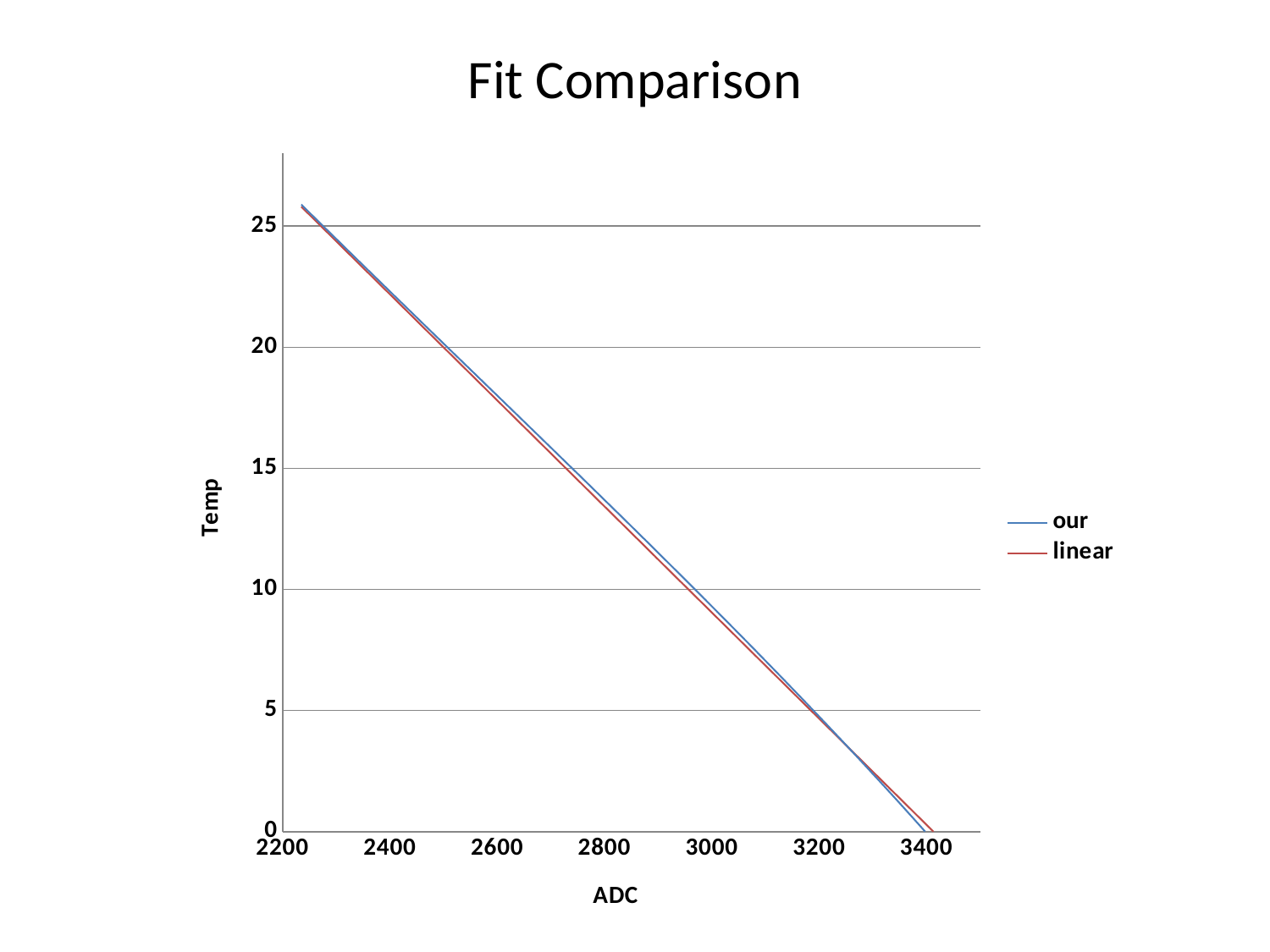
What is the title of the chart? Fit Comparison Is the Temp value of the 'linear' series at ADC 3200 greater or less than 10? less Is the Temp value of the 'linear' series at ADC 3000 greater or less than 15? less Which series is drawn in red? linear What kind of chart is shown on the slide? line chart How many series does the legend list? 2 Is the Temp value of the 'linear' series at ADC 2600 greater or less than 15? greater Do the Temp values rise or fall as ADC increases along the x axis? fall